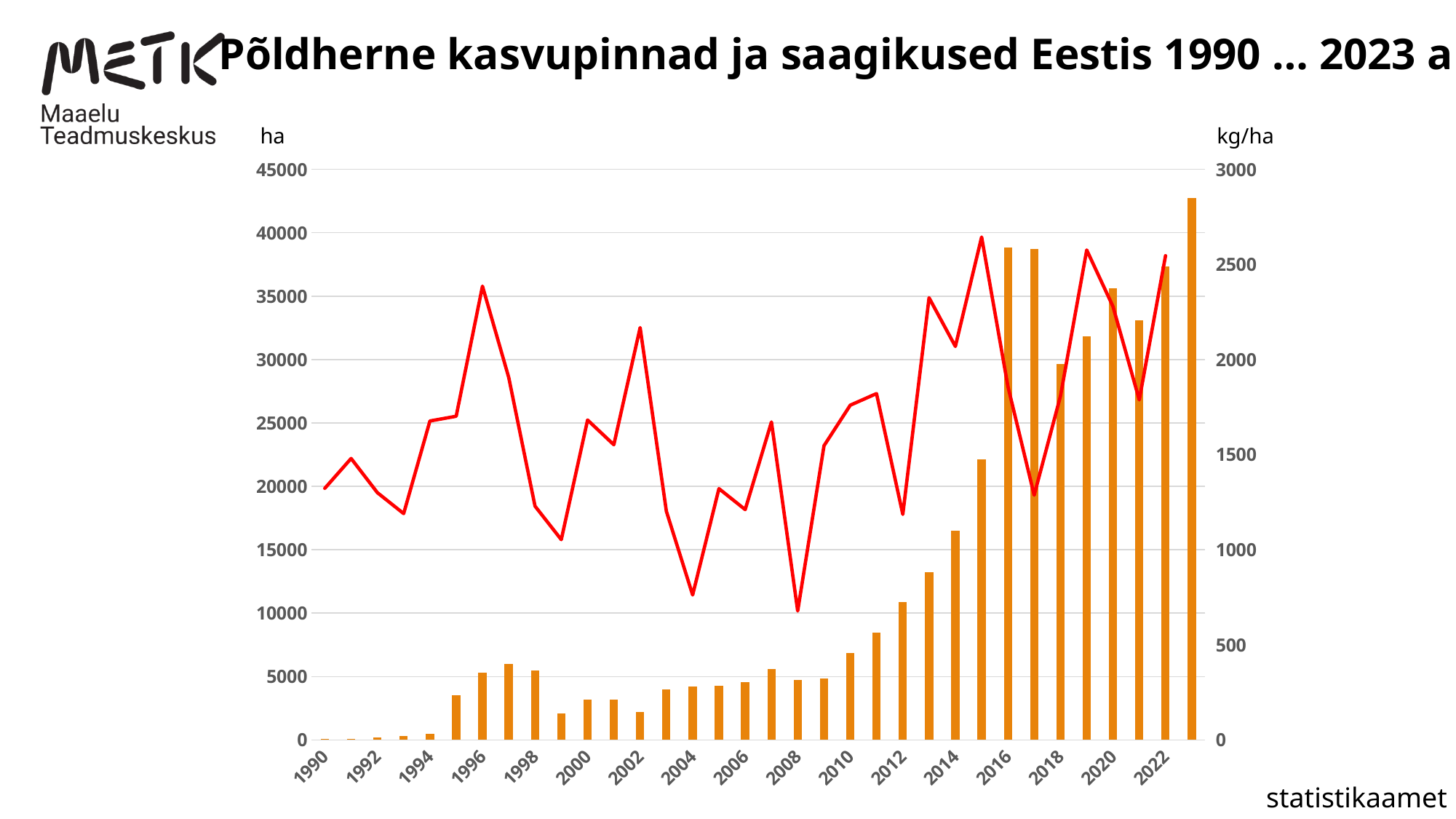
What kind of chart is shown on the slide? A combined bar and line chart Is the bar value for 2012 greater or less than 10000 ha? greater Is the bar value for 1999 greater or less than 5000 ha? less In which year does the red line (kg/ha) reach its lowest point? 2008 Which year has the taller bar, 2016 or 2018? 2016 What unit is shown on the right-hand axis of the chart? kg/ha In which year does the red line (kg/ha) reach its highest point? 2015 Is the bar value for 2023 greater or less than 40000 ha? greater Overall, do the bar values rise or fall from 1990 to 2023? rise Which year has the tallest bar (largest area in ha)? 2023